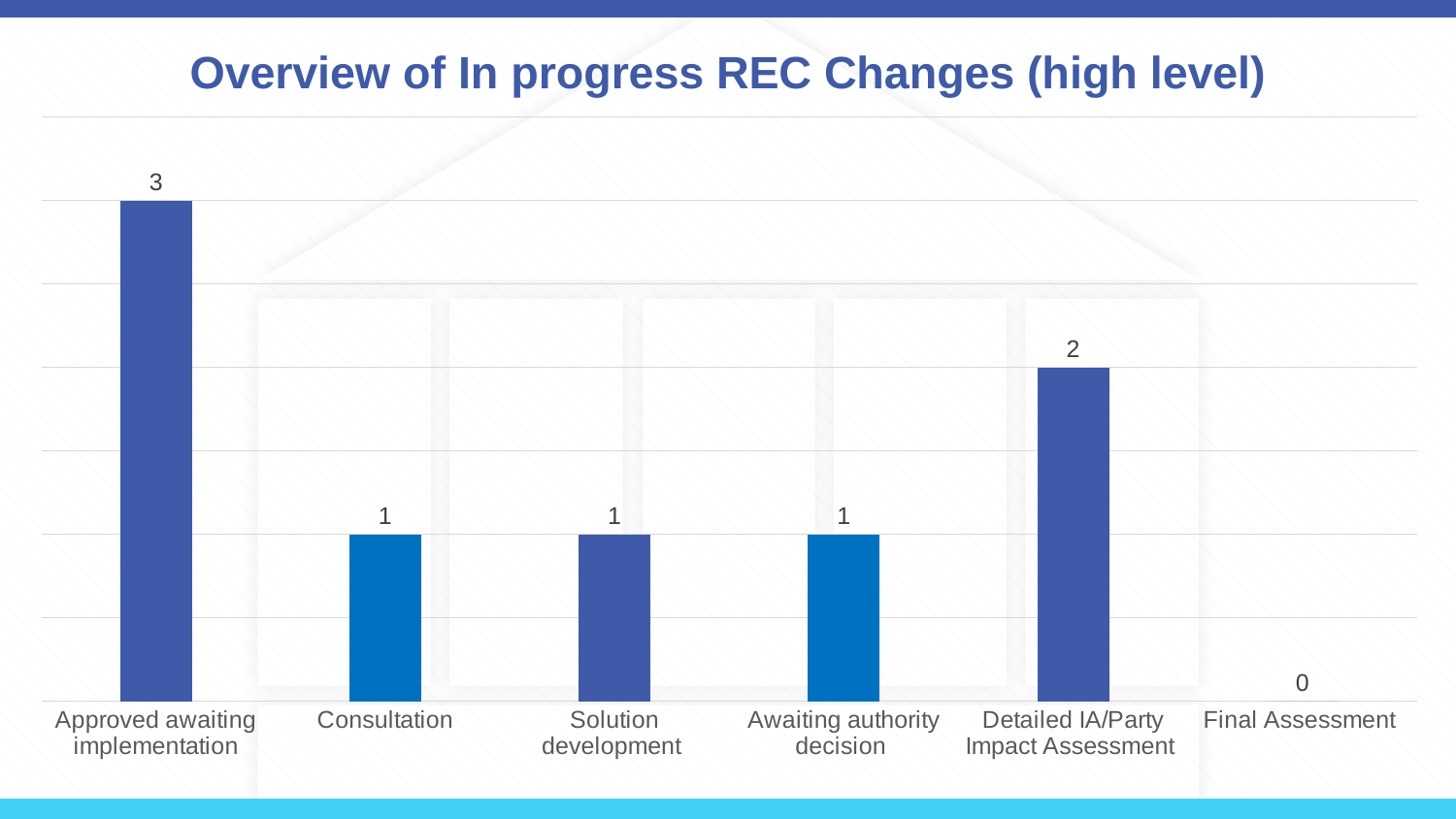
What is the title of the slide? Overview of In progress REC Changes (high level) What is the value for Final Assessment? 0 What is the value for Detailed IA/Party Impact Assessment? 2 Which category has the highest value? Approved awaiting implementation Which category has the lowest value? Final Assessment Which is larger, Detailed IA/Party Impact Assessment or Solution development? Detailed IA/Party Impact Assessment What is the value for Approved awaiting implementation? 3 What kind of chart is shown on the slide? Bar chart What is the value for Consultation? 1 How many categories are shown on the x axis? 6 How many categories have a value of 1? 3 What is the difference between Approved awaiting implementation and Detailed IA/Party Impact Assessment? 1